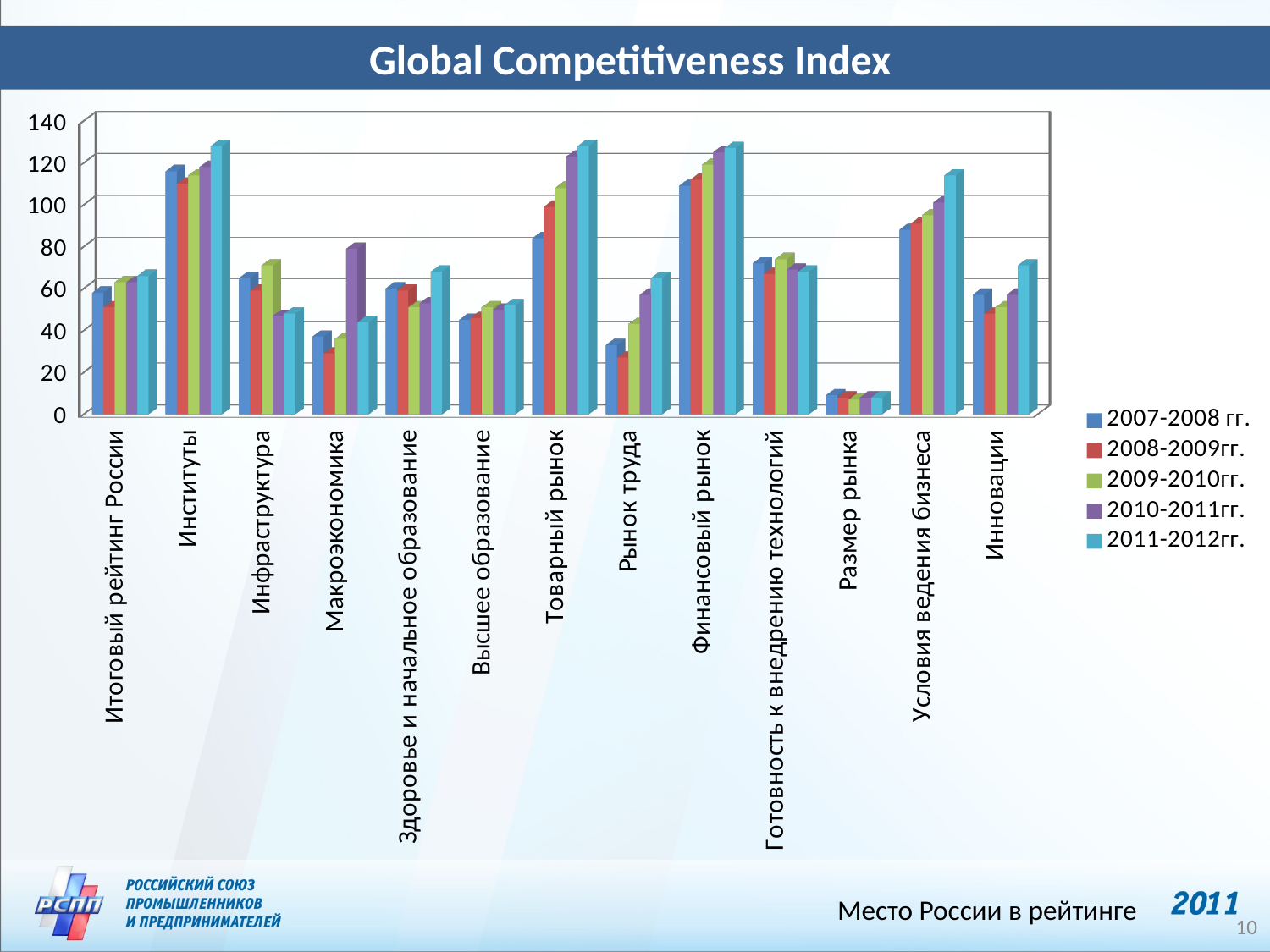
For Товарный рынок, do the values rise or fall from the 2007-2008 гг. series to the 2011-2012гг. series? rise For the 2007-2008 гг. series, which is larger: Институты or Инфраструктура? Институты How many categories are shown along the x axis of the chart? 13 Which category has the lowest 2011-2012гг. value? Размер рынка What is the title of the chart? Global Competitiveness Index Is the 2011-2012гг. value for Институты greater or less than 120? greater Is the 2011-2012гг. value for Условия ведения бизнеса greater or less than 100? greater Is the 2007-2008 гг. value for Размер рынка greater or less than 20? less Which series is listed first in the legend? 2007-2008 гг. How many series does the legend list? 5 What kind of chart is shown on the slide? bar chart